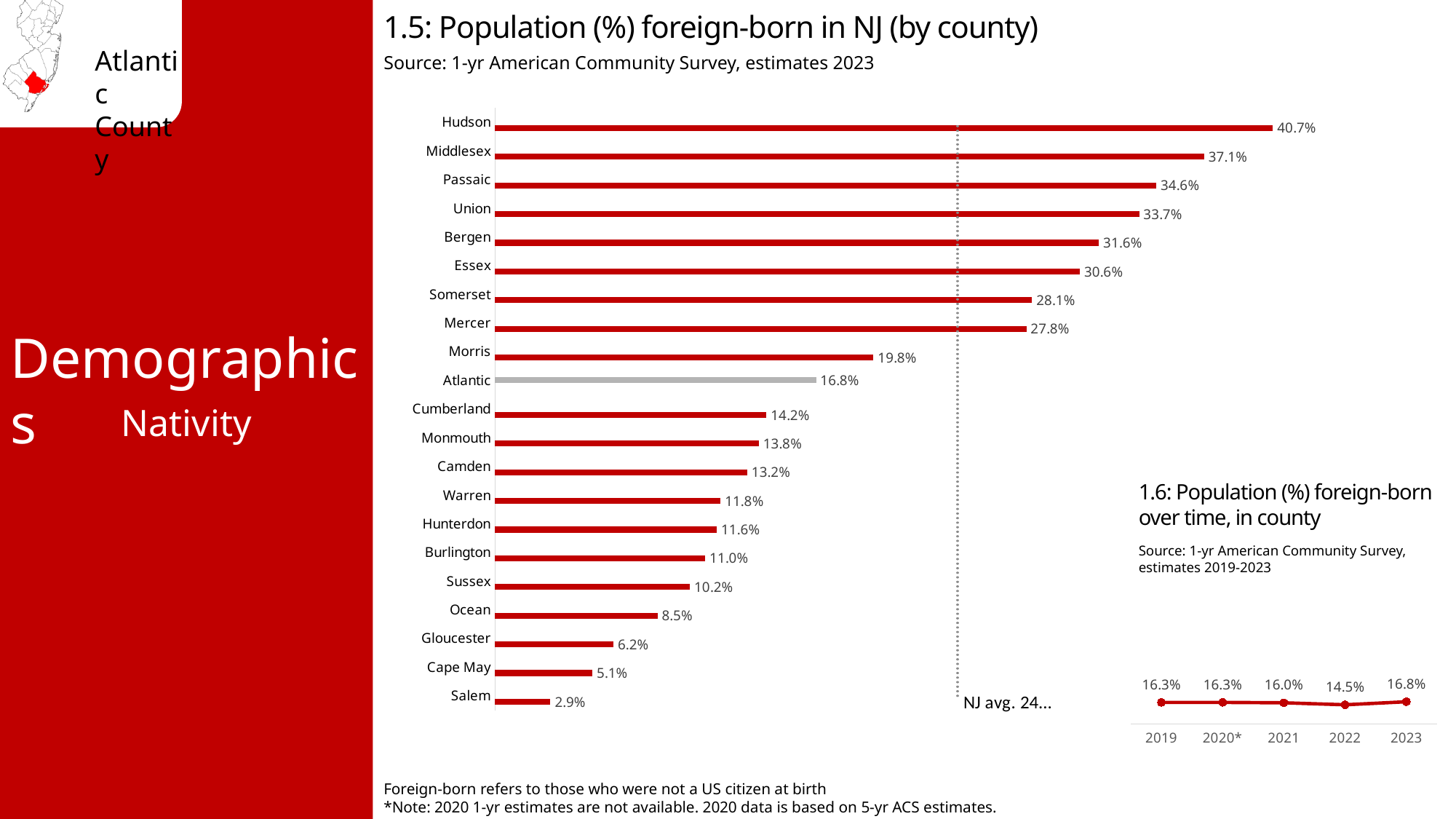
What kind of chart is chart 1.6 (Population (%) foreign-born over time, in county)? Line chart In chart 1.5 (Population (%) foreign-born in NJ by county), what is the value for Atlantic? 16.8% In chart 1.6 (Population (%) foreign-born over time, in county), what is the value for 2022? 14.5% In chart 1.5 (Population (%) foreign-born in NJ by county), what is the difference between Hudson and Middlesex? 3.6% In chart 1.5 (Population (%) foreign-born in NJ by county), which county has the highest value? Hudson In chart 1.6 (Population (%) foreign-born over time, in county), how many data points are plotted? 5 What kind of chart is chart 1.5 (Population (%) foreign-born in NJ by county)? Bar chart In chart 1.5 (Population (%) foreign-born in NJ by county), how many counties are shown? 21 In chart 1.5 (Population (%) foreign-born in NJ by county), which is larger, Camden or Cumberland? Cumberland In chart 1.6 (Population (%) foreign-born over time, in county), which year has the lowest value? 2022 In chart 1.5 (Population (%) foreign-born in NJ by county), what is the value for Passaic? 34.6% In chart 1.5 (Population (%) foreign-born in NJ by county), which county has the lowest value? Salem